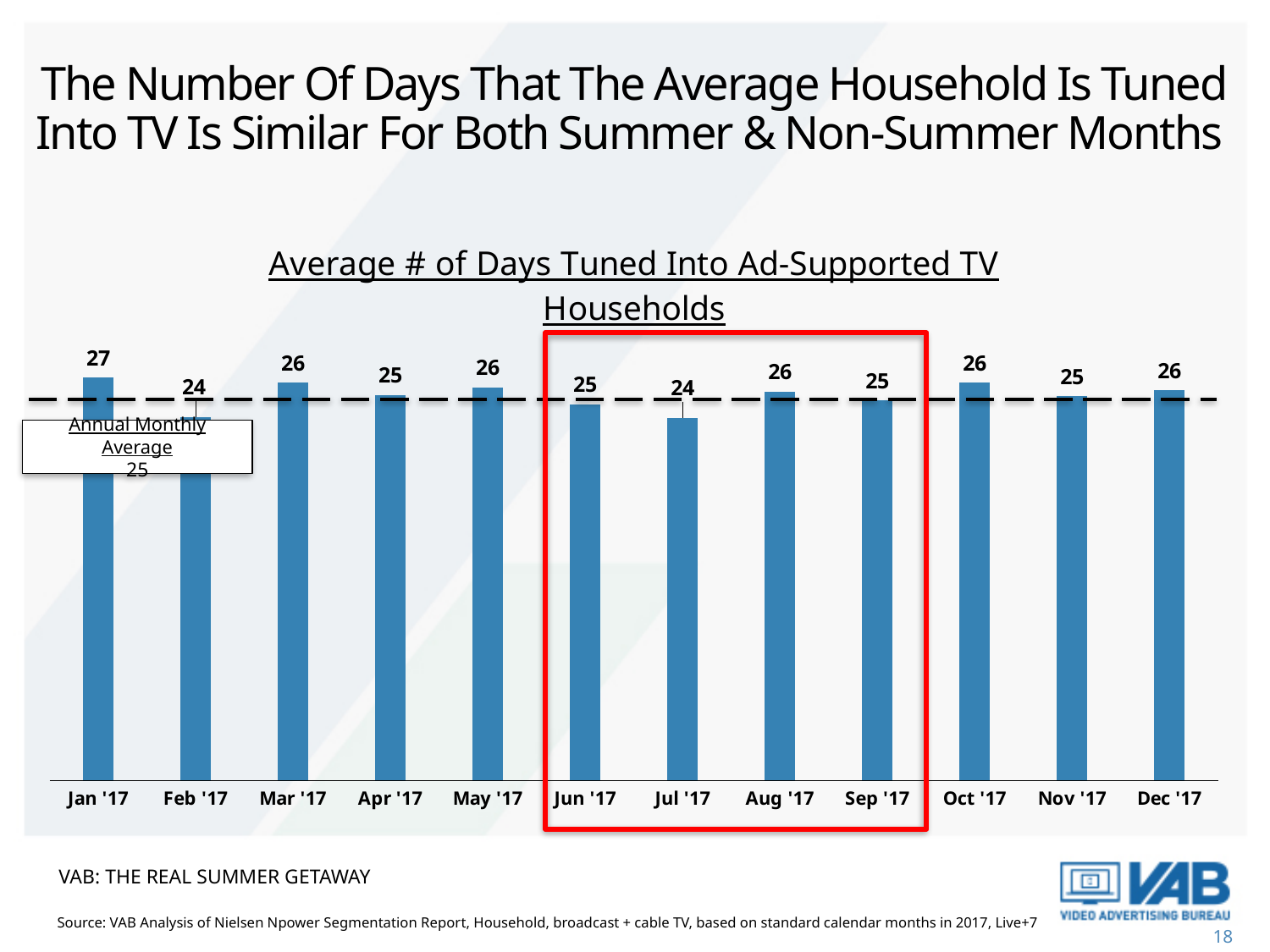
What is the value shown for Aug '17? 26 What is the difference between the values for Jan '17 and Jul '17? 3 What is the annual monthly average indicated by the dashed line? 25 How many months are plotted on the chart? 12 What is the difference between the values for Feb '17 and Mar '17? 2 What is the average number of days tuned into ad-supported TV for Jan '17? 27 Which month has the highest average number of days tuned into ad-supported TV? Jan '17 Which months are enclosed by the red box on the chart? Jun '17, Jul '17, Aug '17, Sep '17 Which is larger, the value for Mar '17 or the value for Apr '17? Mar '17 What is the value shown for Jul '17? 24 What is the title of the chart? Average # of Days Tuned Into Ad-Supported TV Households What kind of chart is shown on the slide? Bar chart